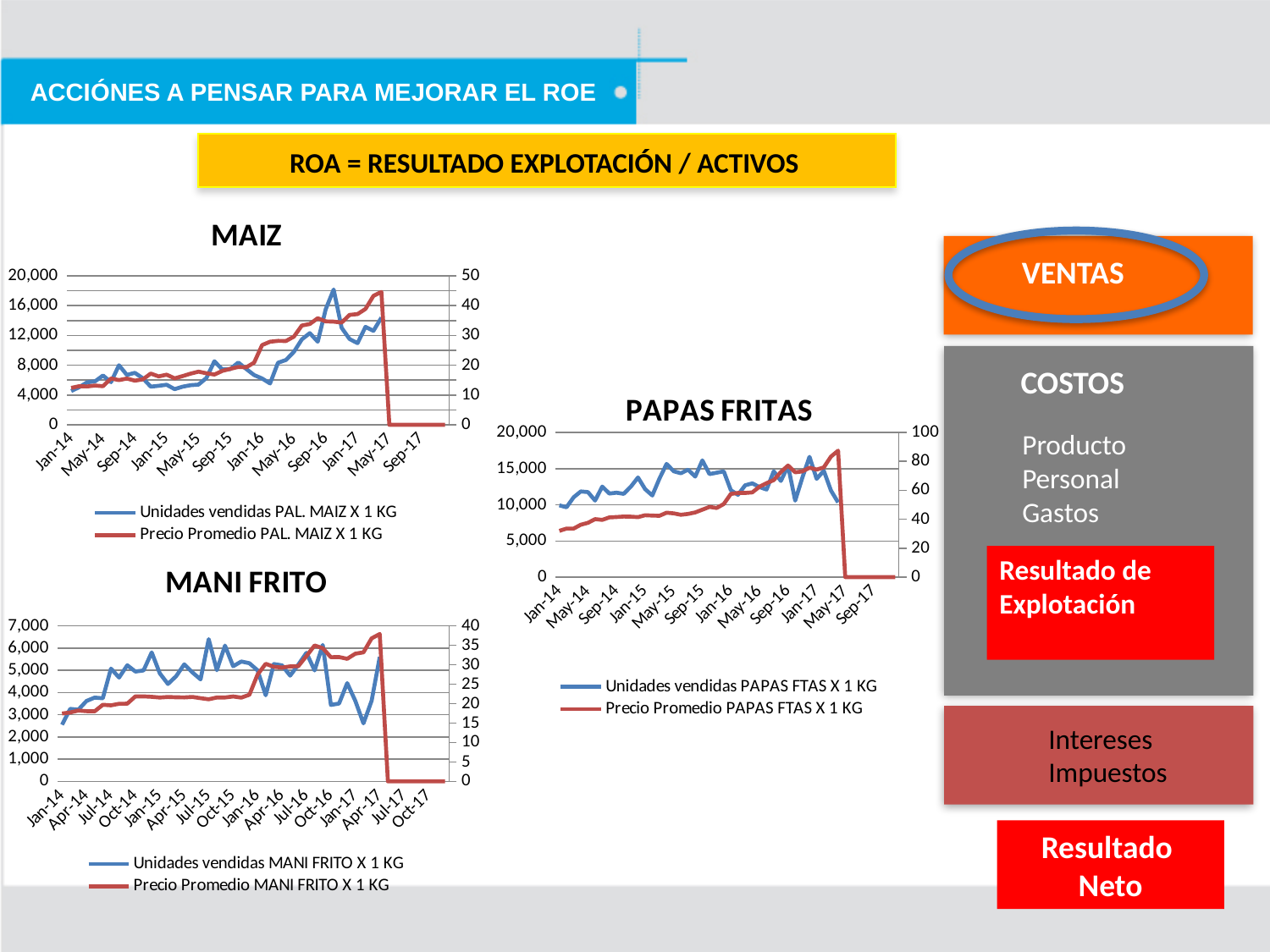
How many series does the legend of the MAIZ chart list? 2 In the PAPAS FRITAS chart, is the value of Precio Promedio PAPAS FTAS X 1 KG at Jan-14 greater or less than 40? less What kind of chart is the MANI FRITO chart? line chart What is the title of the chart at the bottom left of the slide? MANI FRITO How many charts are shown on the slide? 3 In the MAIZ chart, is the highest value of Unidades vendidas PAL. MAIZ X 1 KG greater or less than 16,000? greater In the PAPAS FRITAS chart, does the Unidades vendidas PAPAS FTAS X 1 KG line generally rise or fall between Jan-14 and Jan-17? rise How many series does the legend of the PAPAS FRITAS chart list? 2 In the MAIZ chart, is the value of Unidades vendidas PAL. MAIZ X 1 KG at Jan-14 greater or less than 8,000? less What kind of chart is the MAIZ chart? line chart In the MAIZ chart, does the Precio Promedio PAL. MAIZ X 1 KG line rise or fall between Jan-14 and Jan-17? rise What are the two legend entries of the PAPAS FRITAS chart? Unidades vendidas PAPAS FTAS X 1 KG; Precio Promedio PAPAS FTAS X 1 KG